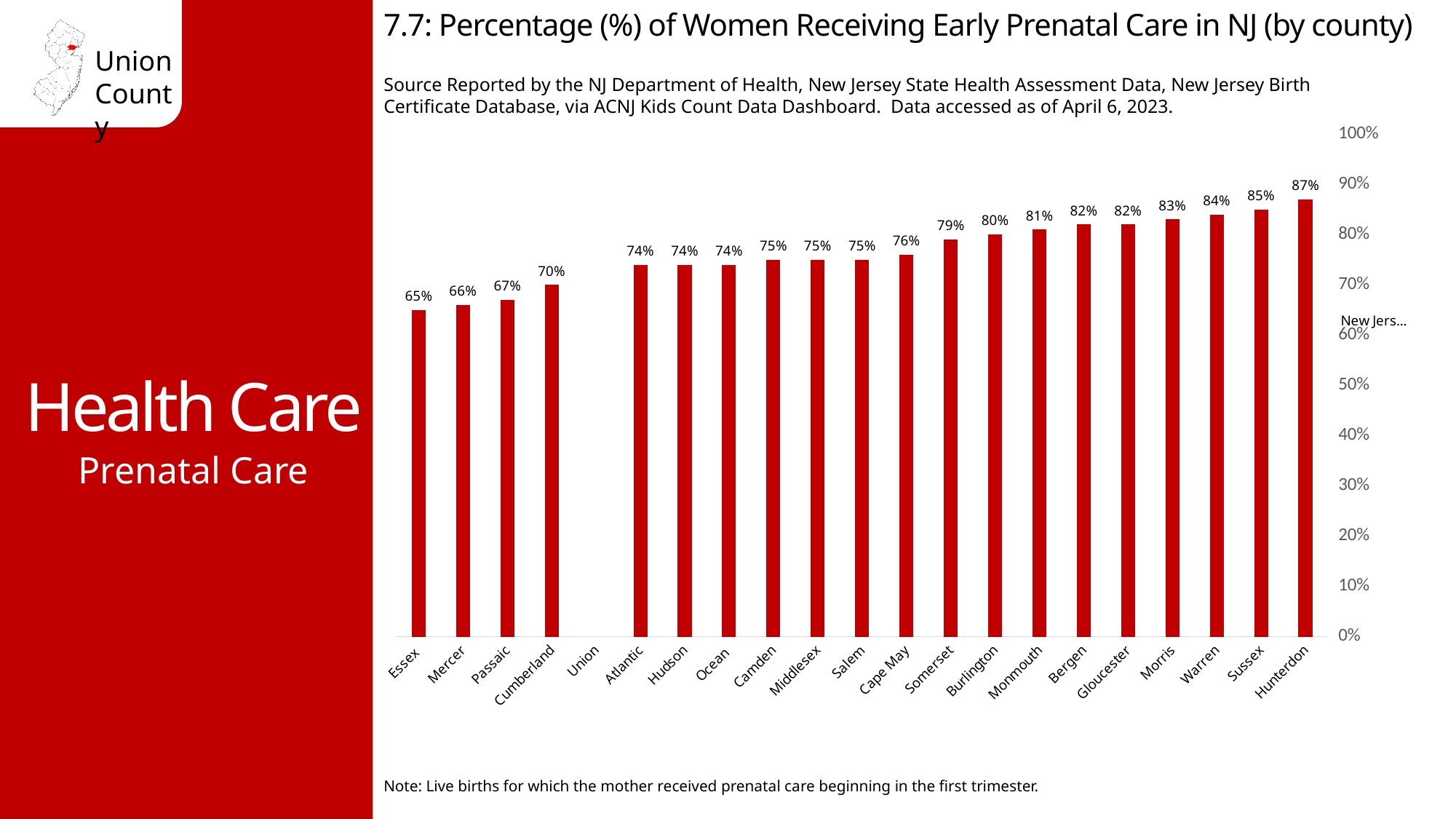
Which county on the x axis has no bar plotted? Union Which county has the highest percentage of women receiving early prenatal care? Hunterdon Do the values generally rise or fall moving from left to right along the x axis? Rise How many county labels are shown along the x axis? 21 What is the difference in percentage points between Hunterdon and Essex? 22 percentage points What is the value shown for Somerset county? 79% What kind of chart is used on this slide? Bar chart What percentage of women received early prenatal care in Hunterdon county? 87% Is the value for Mercer county greater or less than 70%? less Which county has the lowest percentage of women receiving early prenatal care? Essex Which county has a higher value, Somerset or Cape May? Somerset What is the value shown for Cumberland county? 70%